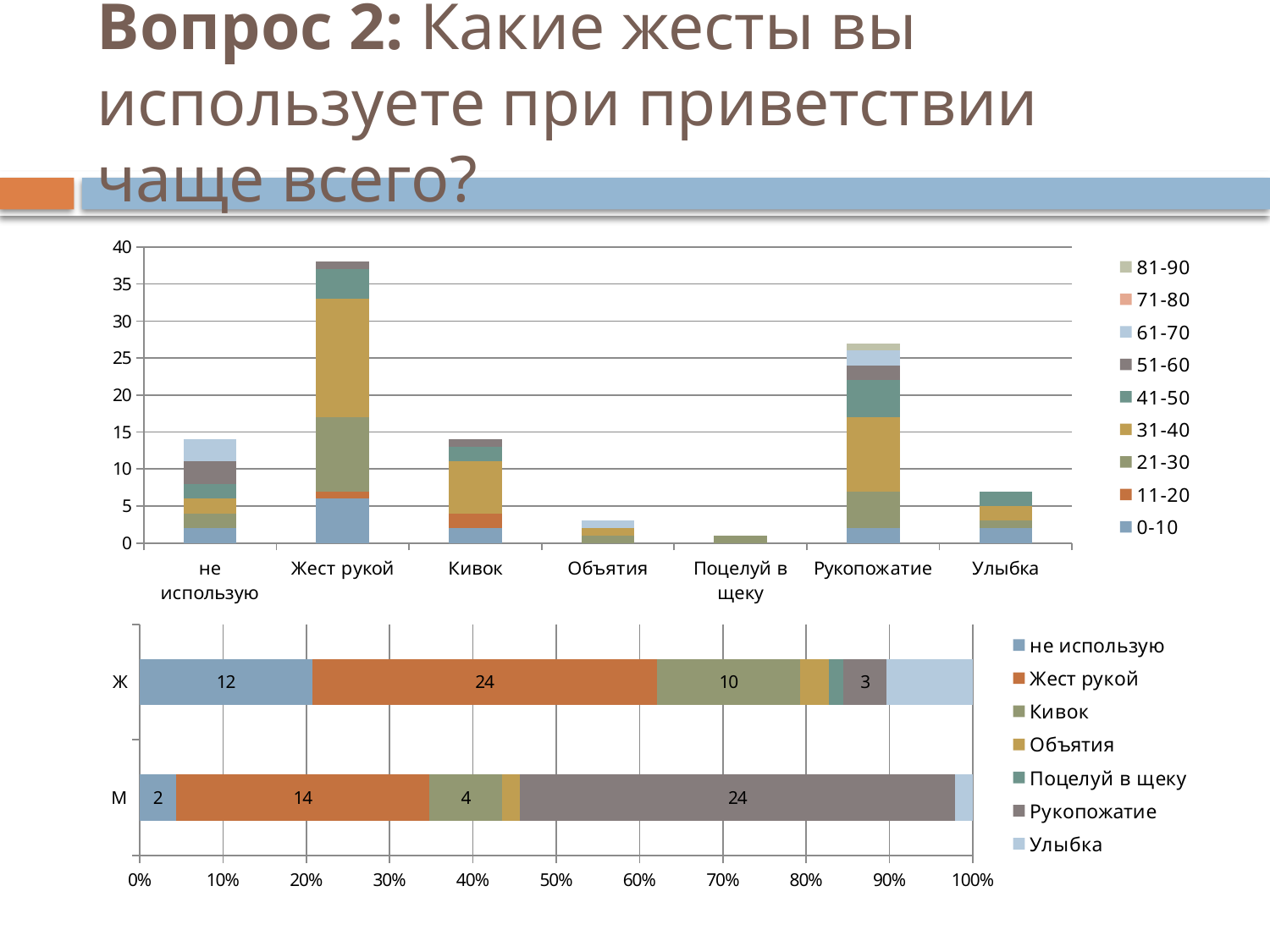
In the bottom chart, what is the value for Кивок in the М bar? 4 In the bottom chart, what is the value for Рукопожатие in the М bar? 24 In the top chart, which category has the tallest stacked bar? Жест рукой In the top chart, how many series does the legend list? 9 In the bottom chart, what is the value for Жест рукой in the Ж bar? 24 In the bottom chart, what is the difference between не использую for Ж and не использую for М? 10 In the top chart, is the total for Жест рукой greater or less than 35? greater In the top chart, which category has the shortest stacked bar? Поцелуй в щеку In the top chart, how many categories are shown on the x axis? 7 What kind of chart is the bottom chart? bar chart In the top chart, is the total for Объятия greater or less than 5? less In the bottom chart, which is larger: Жест рукой for Ж or Жест рукой for М? Ж